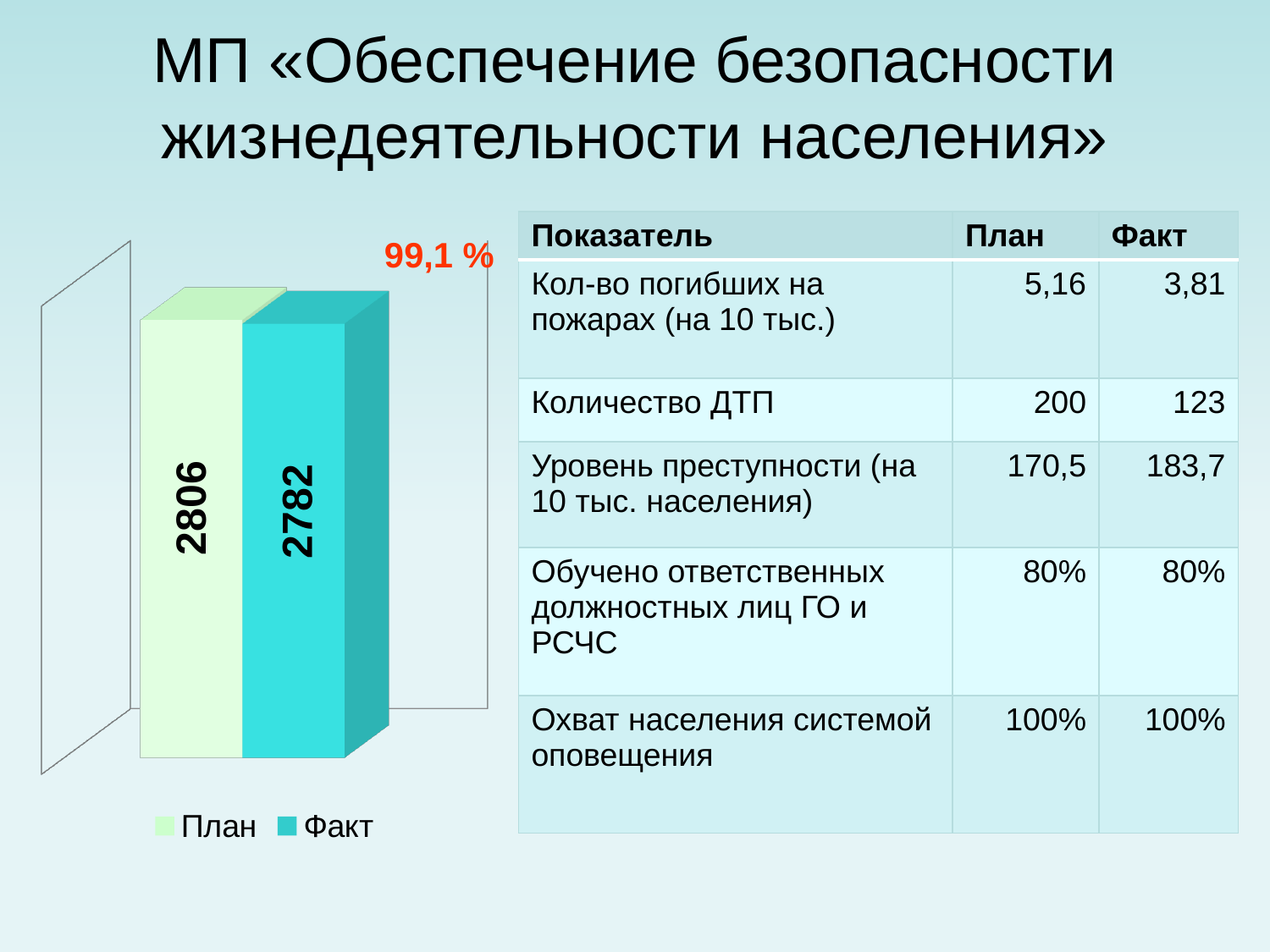
What percentage is printed above the chart? 99,1 % What kind of chart is shown on the slide? Bar chart What is the value of the План bar in the chart? 2806 Which legend entry is shown in teal in the chart? Факт Which series has the higher value in the chart, План or Факт? План What is the difference between the План and Факт values in the chart? 24 What is the value of the Факт bar in the chart? 2782 How many series does the chart legend list? 2 Which bar in the chart is the highest? План Which bar in the chart is the lowest? Факт How many bars are plotted in the chart? 2